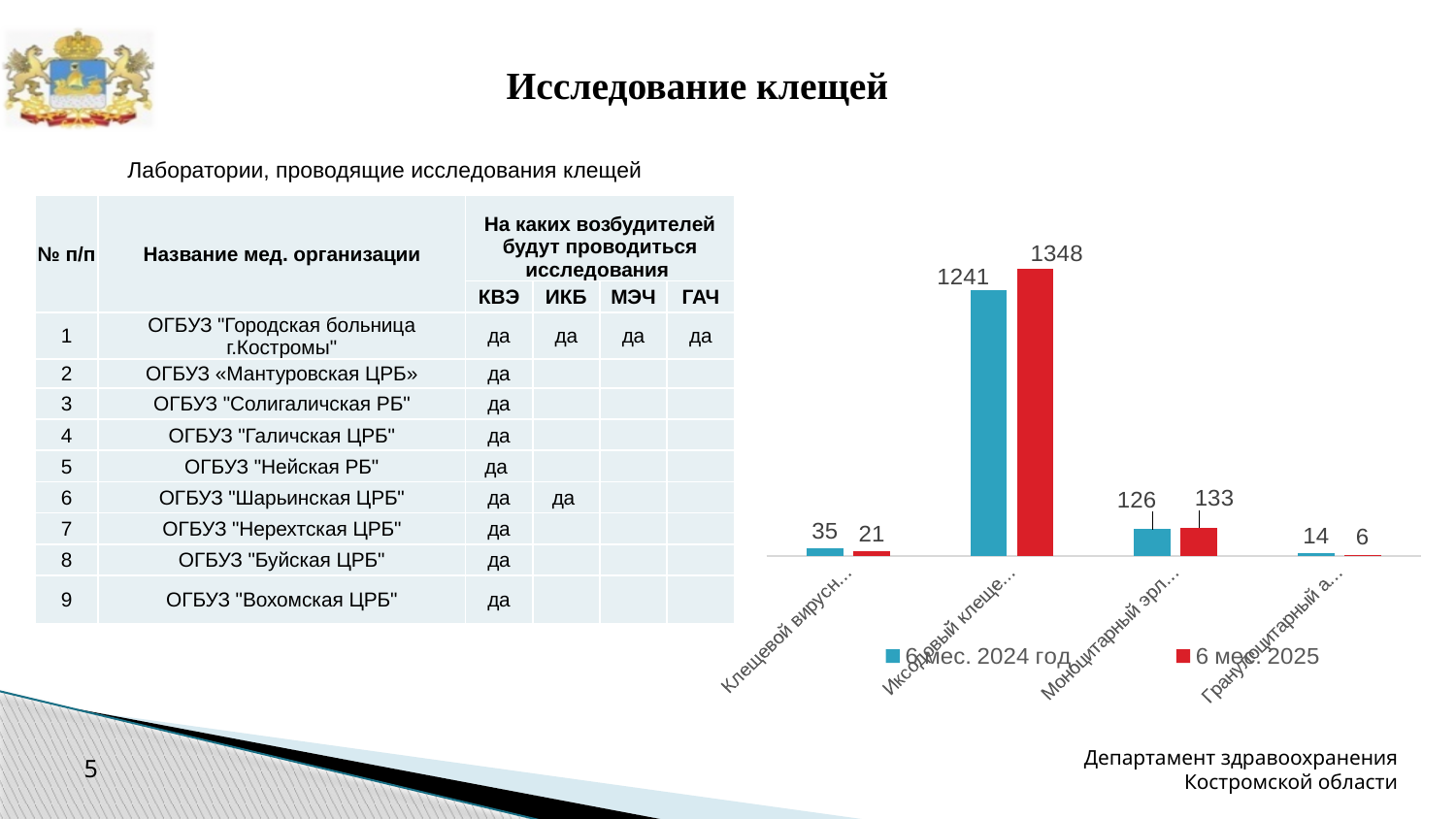
Which category has the lowest value for the '6 мес. 2025' series in the chart? the fourth category from the left How many categories are plotted along the x axis of the chart? 4 What is the value of the '6 мес. 2024 год' series for the fourth category from the left in the chart? 14 What type of chart is shown on the right side of the slide? bar chart In the chart, for the third category from the left, which series has the larger value: '6 мес. 2024 год' or '6 мес. 2025'? 6 мес. 2025 Which category has the highest value for the '6 мес. 2025' series in the chart? the second category from the left What are the two legend entries of the chart? 6 мес. 2024 год and 6 мес. 2025 What is the value of the '6 мес. 2025' series for the second category from the left in the chart? 1348 What is the value of the '6 мес. 2024 год' series for the second category from the left in the chart? 1241 How many series does the legend of the chart list? 2 In the chart, what is the difference between the '6 мес. 2025' and '6 мес. 2024 год' values for the second category from the left? 107 What is the value of the '6 мес. 2025' series for the first category from the left in the chart? 21